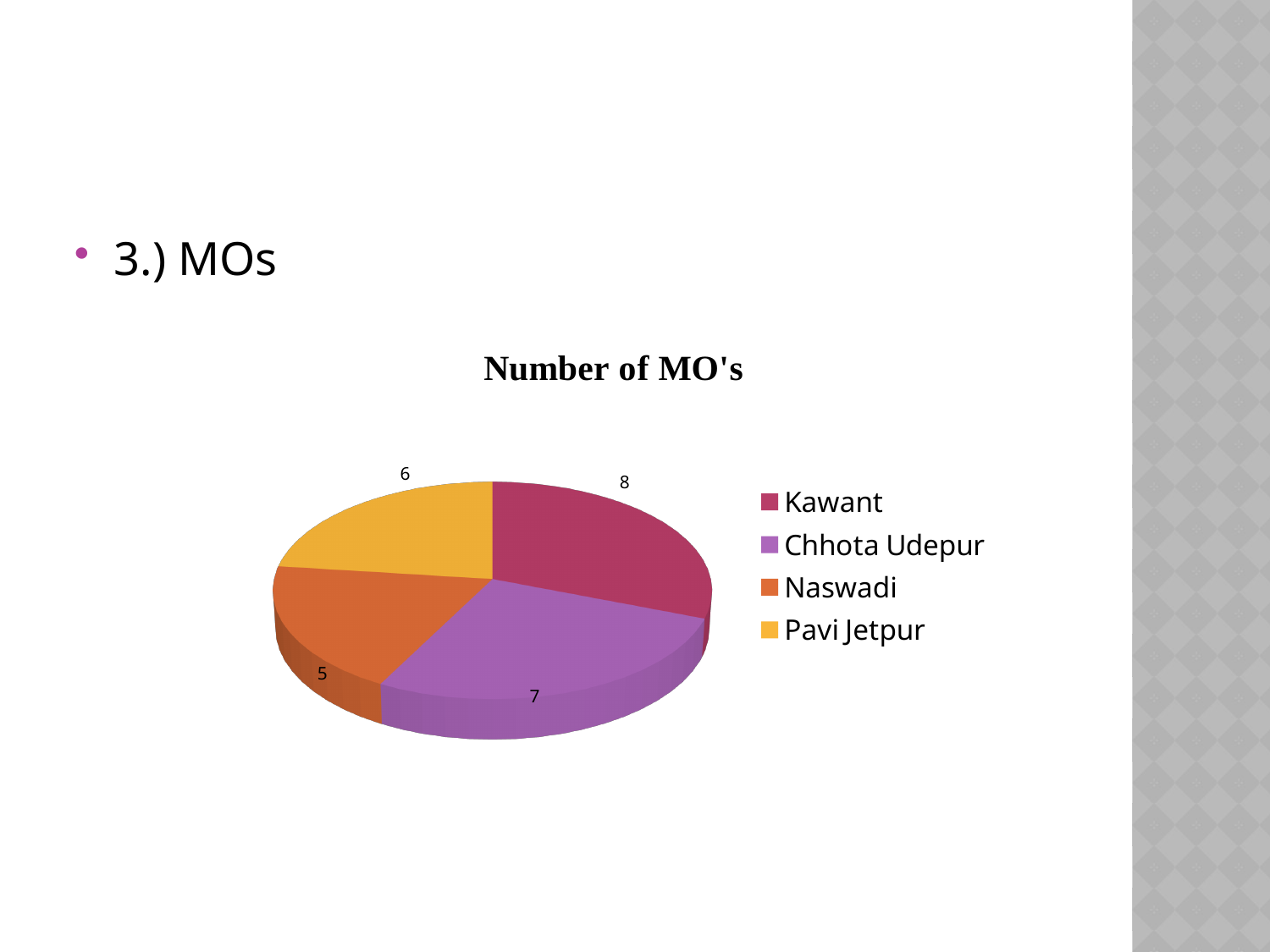
Which has more MOs, Chhota Udepur or Pavi Jetpur? Chhota Udepur How many MOs does Naswadi have? 5 What is the difference between the number of MOs in Kawant and Naswadi? 3 How many MOs does Chhota Udepur have? 7 How many MOs does Pavi Jetpur have? 6 What is the total number of MOs across all four categories? 26 What type of chart is shown on the slide? pie chart Which category has the lowest number of MOs? Naswadi How many MOs does Kawant have? 8 What is the title of the chart? Number of MO's Which category has the highest number of MOs? Kawant How many categories are shown in the pie chart? 4